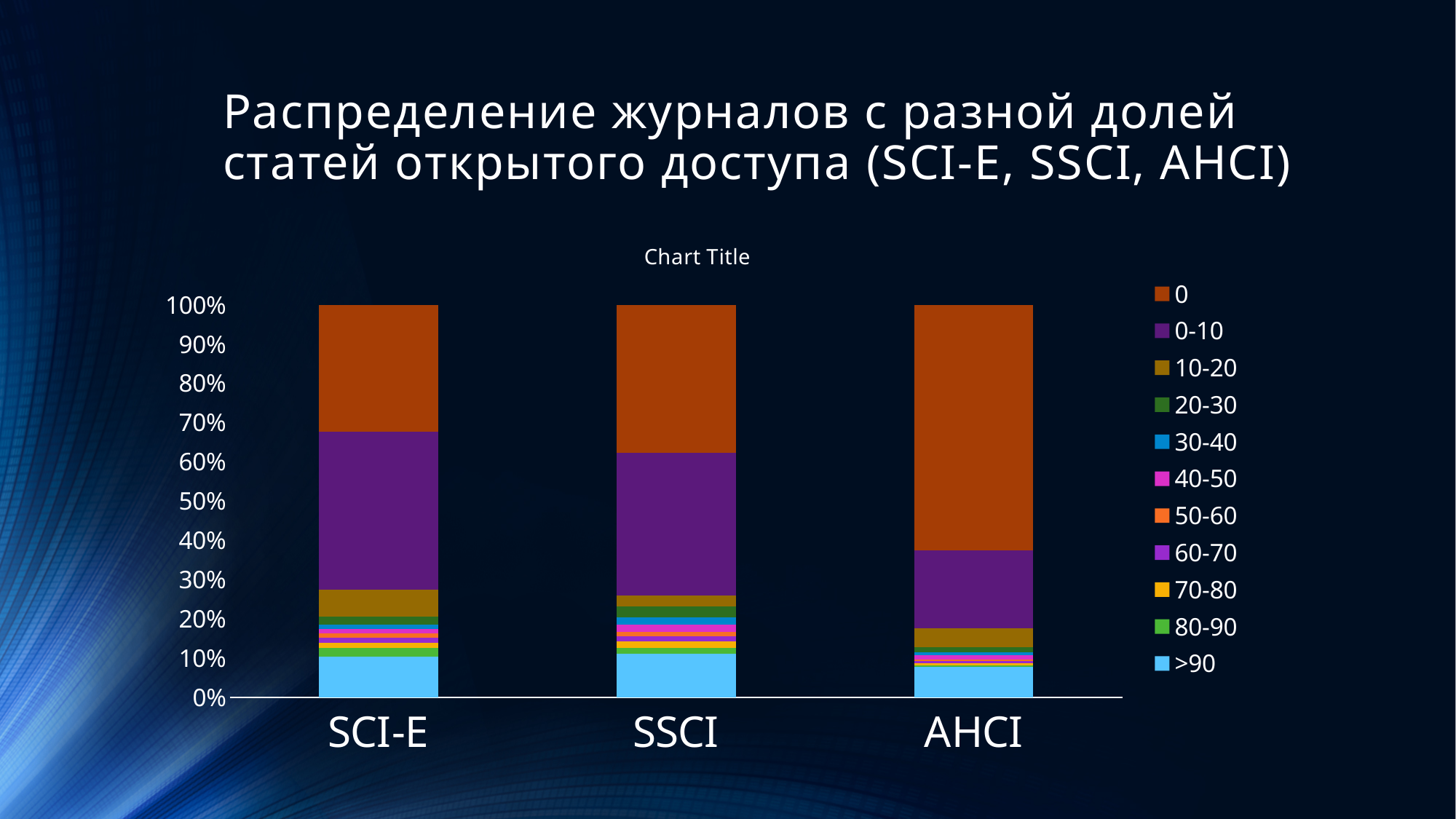
What is the total height of the stacked bar for SCI-E? 100% Which is larger: the "0-10" segment for SCI-E or the "0-10" segment for AHCI? SCI-E Is the "0-10" segment for AHCI greater or less than 30%? less How many series does the chart's legend list? 11 Is the "0-10" segment for SCI-E greater or less than 30%? greater How many categories are shown on the x axis of the chart? 3 Which is larger: the "0" segment for AHCI or the "0" segment for SCI-E? AHCI What is the last entry listed in the chart's legend? >90 What kind of chart is shown on the slide? stacked bar chart Is the "0" segment for AHCI greater or less than 50%? greater Which category has the largest segment for the series "0"? AHCI